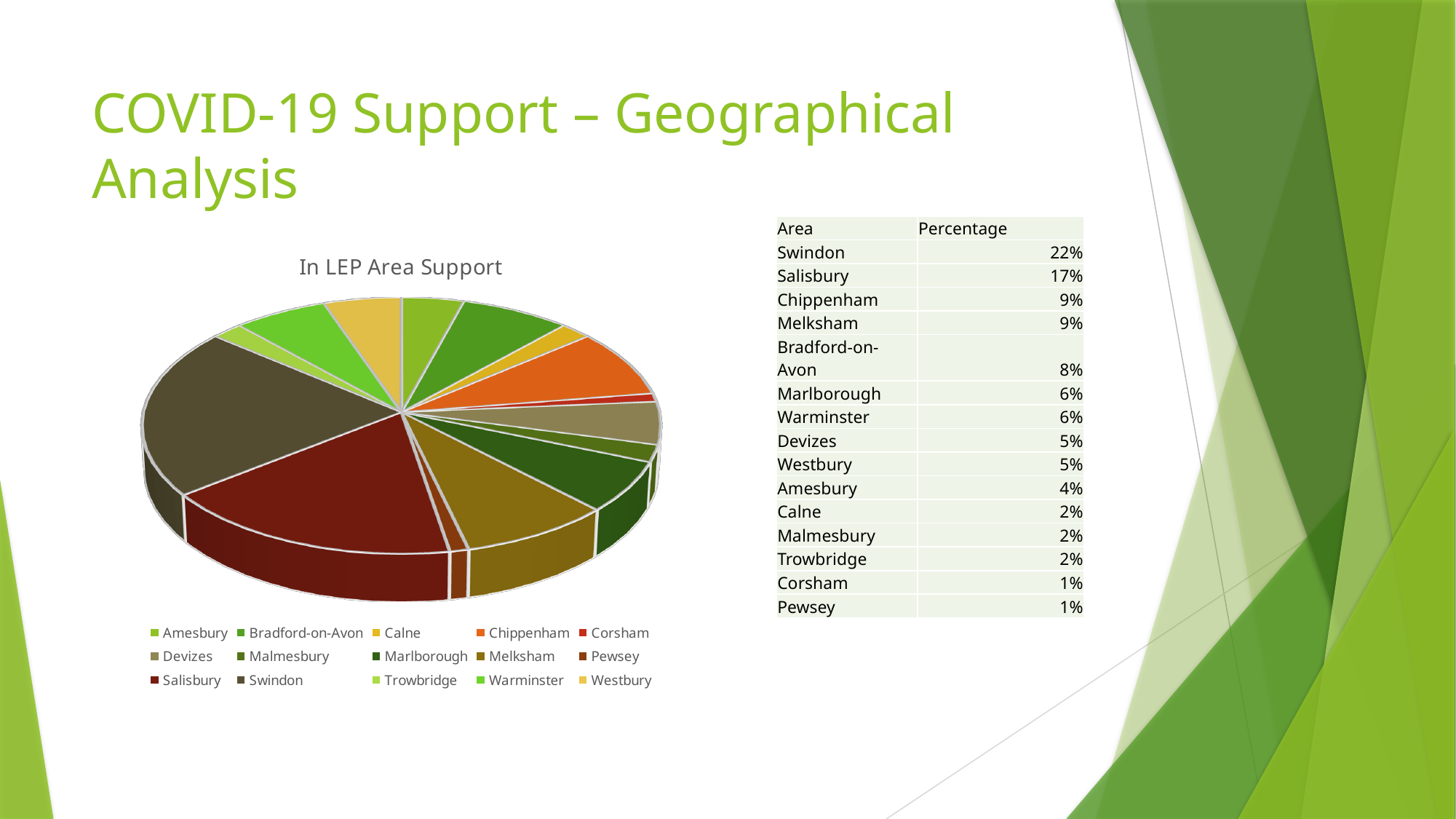
What percentage does Amesbury account for? 4% What is the combined percentage of Swindon and Salisbury? 39% How many areas does the pie chart's legend list? 15 Which is larger, the share for Salisbury or the share for Melksham? Salisbury What percentage do Corsham and Pewsey each account for? 1% What kind of chart is shown on the slide? Pie chart Which area has the largest share of the pie chart? Swindon What is the difference in percentage points between Swindon and Salisbury? 5 According to the table, what percentage does Bradford-on-Avon account for? 8% According to the table, what percentage does Salisbury account for? 17% Which is larger, the share for Chippenham or the share for Devizes? Chippenham What is the title of the pie chart? In LEP Area Support